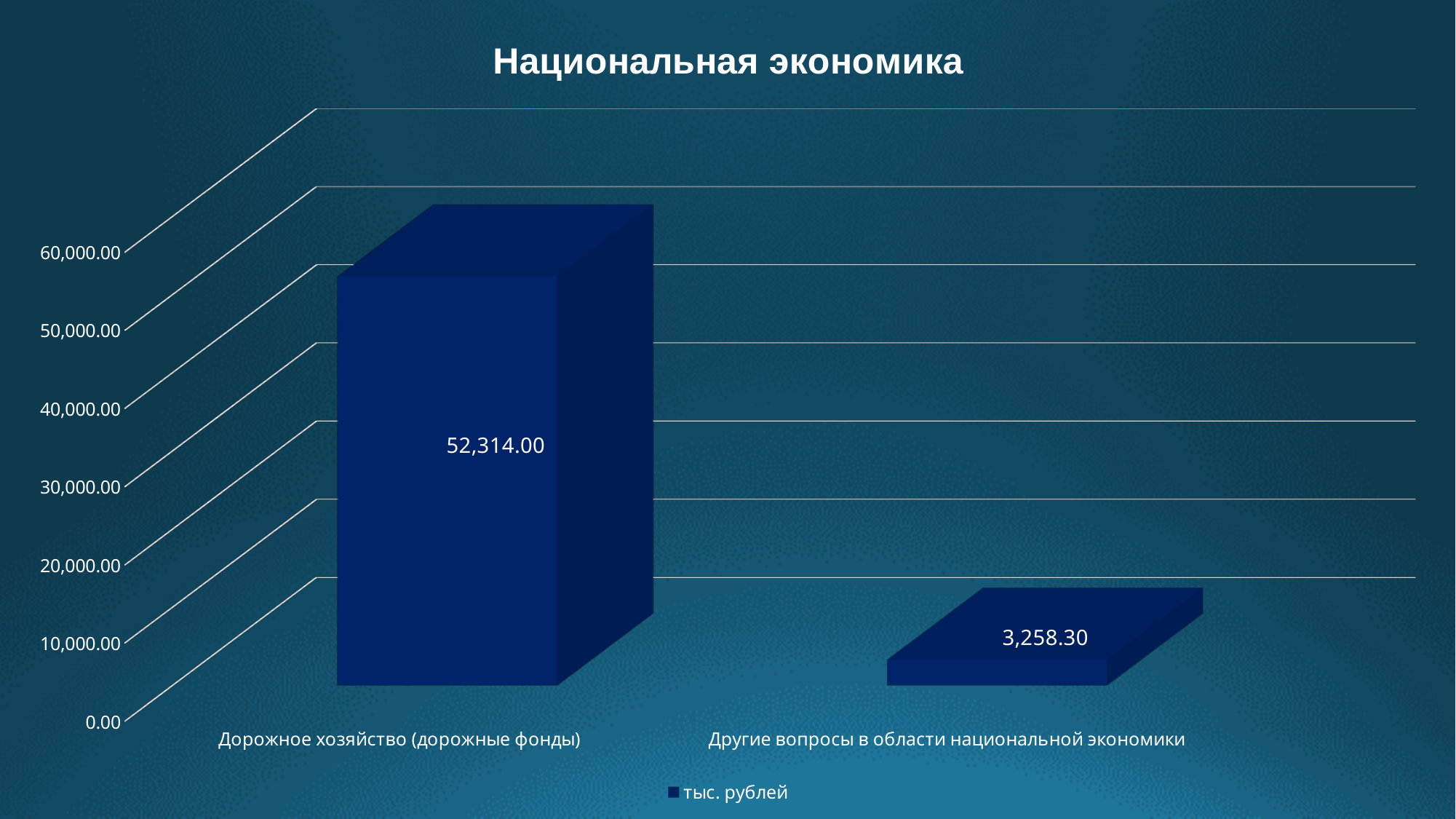
How many series does the legend list? 1 Which category has the highest value? Дорожное хозяйство (дорожные фонды) What is the value for Дорожное хозяйство (дорожные фонды)? 52,314.00 Is the value for Дорожное хозяйство (дорожные фонды) greater or less than 50,000.00? greater What is the title of the chart? Национальная экономика Which is larger: the value for Дорожное хозяйство (дорожные фонды) or for Другие вопросы в области национальной экономики? Дорожное хозяйство (дорожные фонды) What kind of chart is shown on the slide? bar chart Which category has the lowest value? Другие вопросы в области национальной экономики What is the value for Другие вопросы в области национальной экономики? 3,258.30 Is the value for Другие вопросы в области национальной экономики greater or less than 10,000.00? less What is the difference between the values for Дорожное хозяйство (дорожные фонды) and Другие вопросы в области национальной экономики? 49,055.70 How many categories are shown in the chart? 2